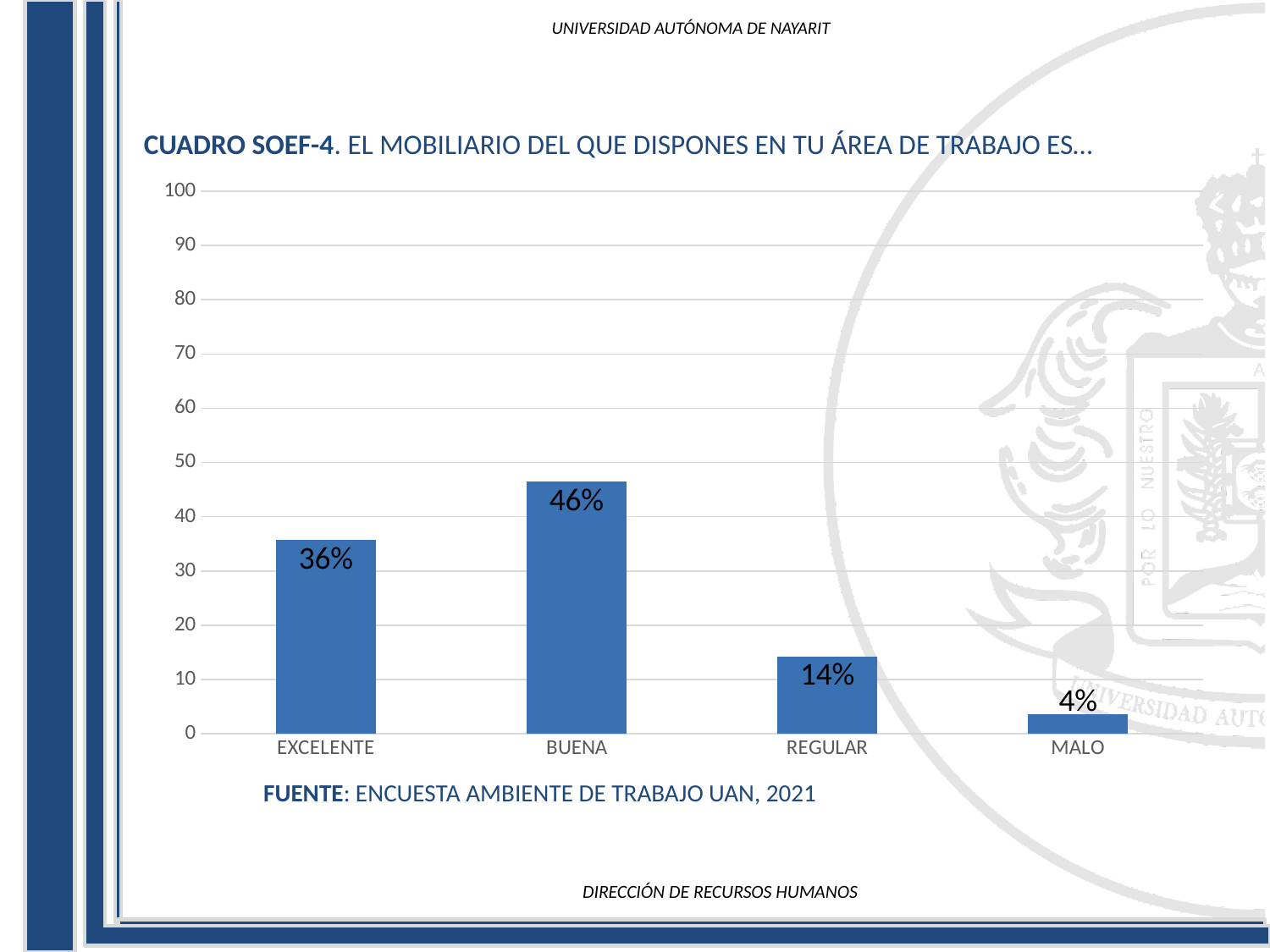
What is the value for EXCELENTE? 36% How many categories are shown on the x axis? 4 What is the difference between the values for BUENA and EXCELENTE? 10% Is the value for BUENA greater or less than 50? less Which is larger, the value for EXCELENTE or the value for REGULAR? EXCELENTE What is the value for MALO? 4% Which category has the lowest value? MALO What kind of chart is shown on the slide? bar chart What is the value for REGULAR? 14% Which category has the highest value? BUENA What is the value for BUENA? 46% What is the difference between the values for REGULAR and MALO? 10%